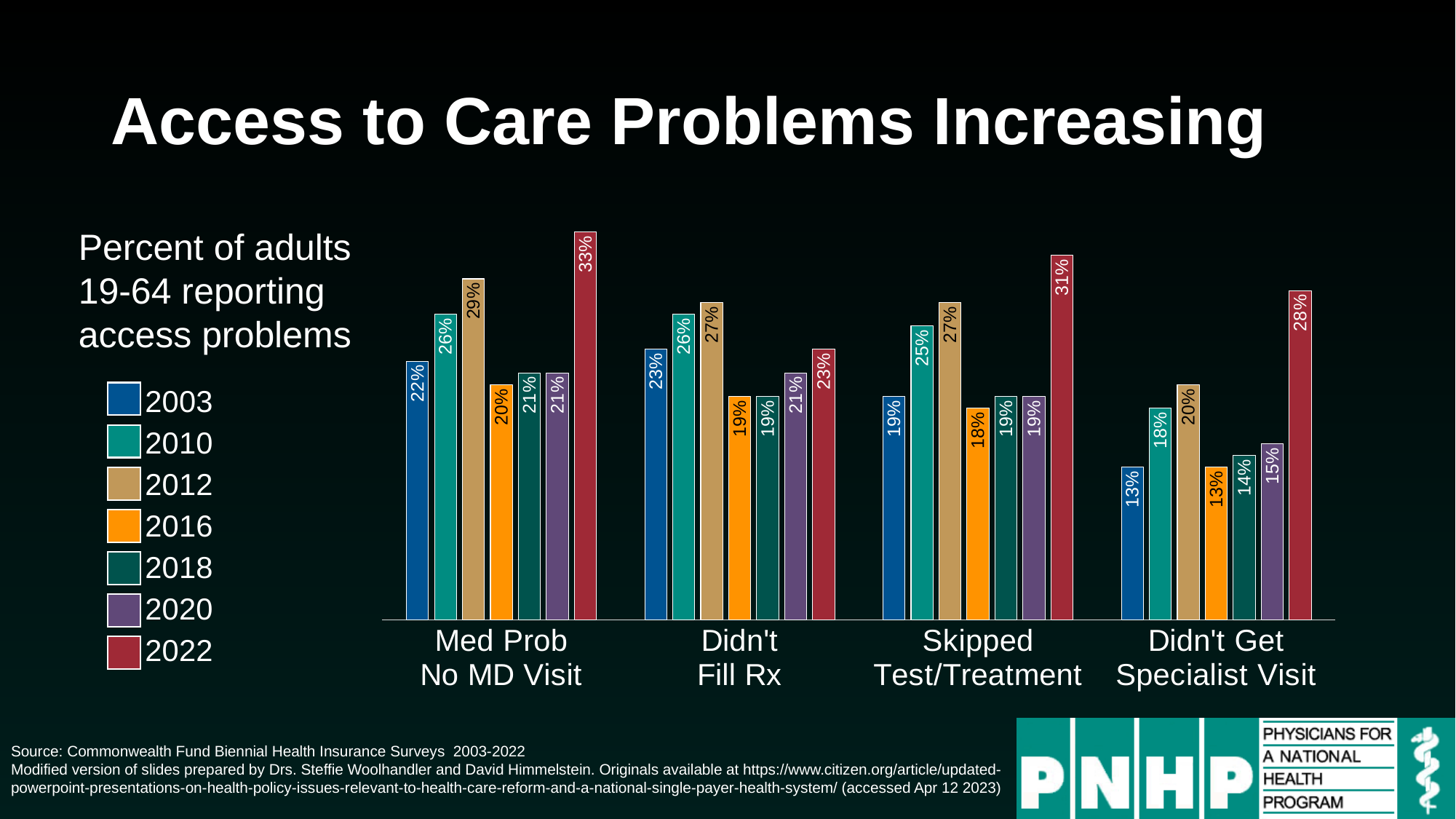
What is the difference between the 2022 and 2003 values for Skipped Test/Treatment? 12 percentage points What percent of adults didn't get a specialist visit in 2012? 20% What percent of adults reported a medical problem but no MD visit in 2022? 33% What kind of chart is shown on the slide? Bar chart How many years does the legend list? 7 What colour represents 2016 in the legend? Orange What percent of adults skipped a test or treatment in 2016? 18% What percent of adults didn't fill a prescription in 2003? 23% Which year has the lowest value for Med Prob No MD Visit? 2016 Which year has the highest value for Didn't Get Specialist Visit? 2022 Which is larger for Didn't Fill Rx: the 2012 value or the 2010 value? 2012 How many access problem categories are shown on the x axis? 4